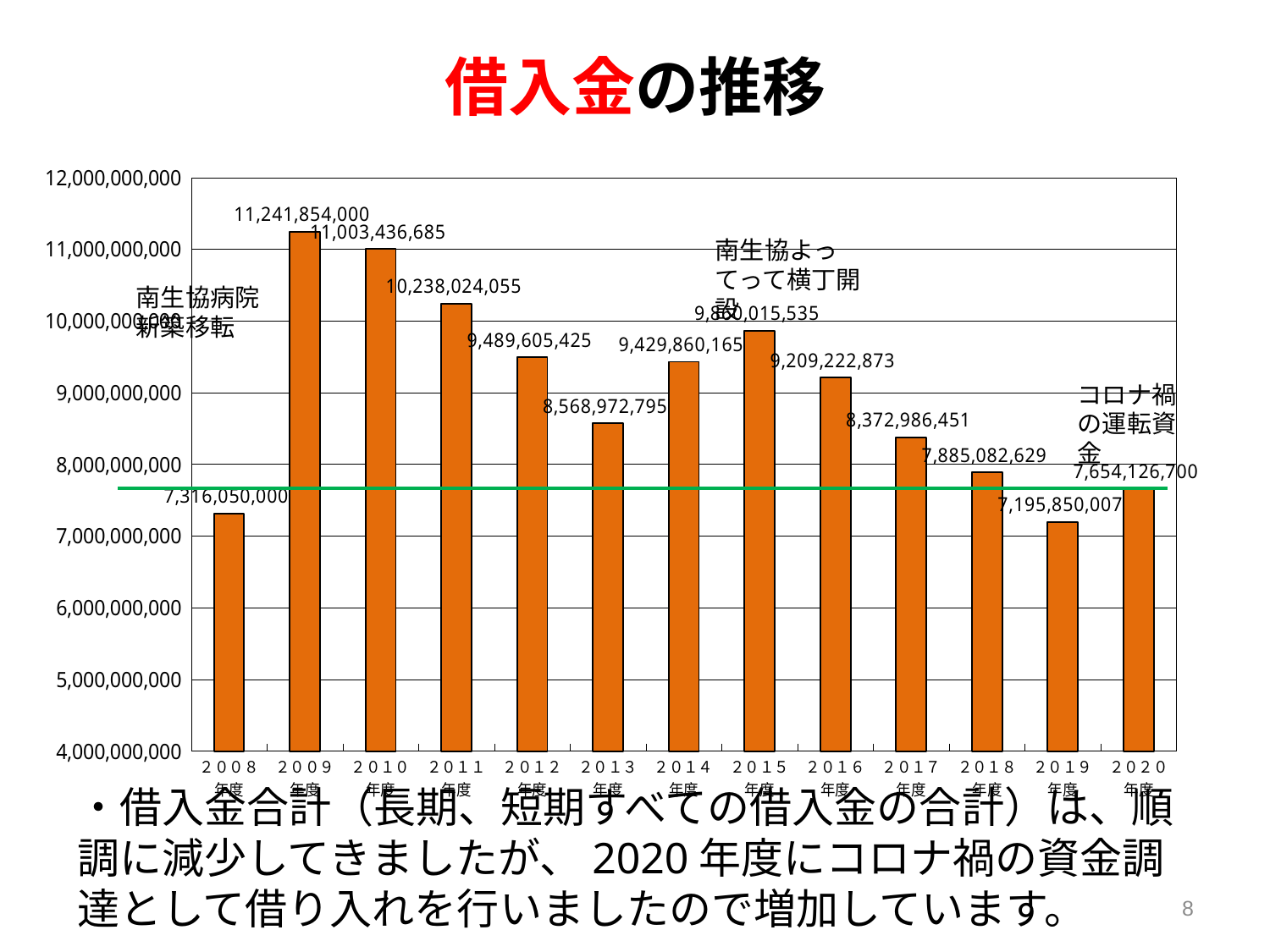
Which year has the highest value? 2009 Which year has the lowest value? 2019 Is the value for 2013年度 greater or less than 9,000,000,000? less Which is larger, the value for 2011年度 or the value for 2016年度? 2011年度 How many years (categories) are plotted on the x axis? 13 What is the value for 2009年度? 11,241,854,000 What kind of chart is shown on the slide? bar chart What is the value for 2019年度? 7,195,850,007 What is the value for 2020年度? 7,654,126,700 What is the title of the chart? 借入金の推移 What is the difference between the values for 2009年度 and 2010年度? 238,417,315 What is the difference between the values for 2020年度 and 2019年度? 458,276,693